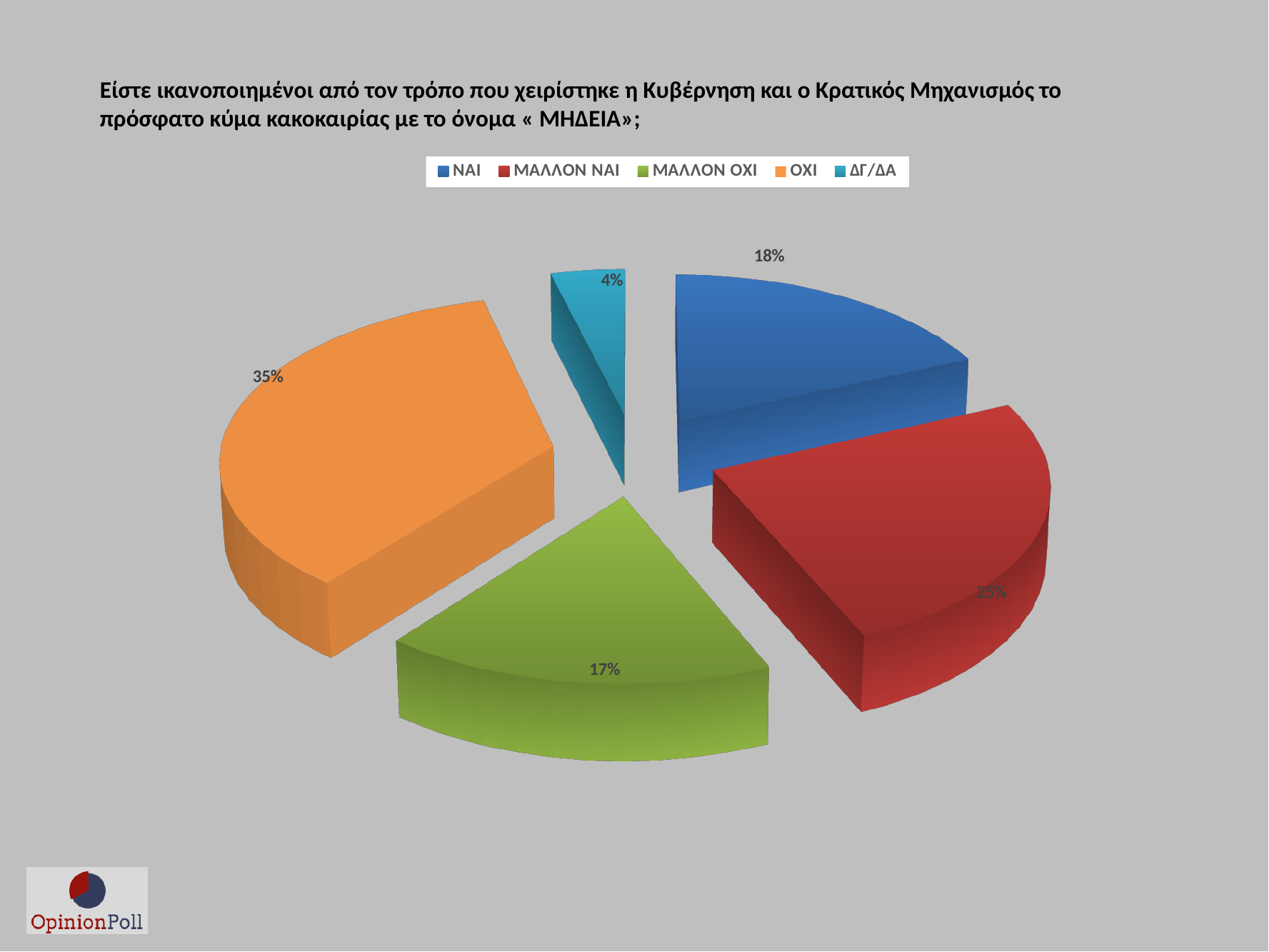
What percentage of respondents answered ΟΧΙ? 35% What colour is the slice for ΟΧΙ? Orange What is the difference in percentage points between ΟΧΙ and ΝΑΙ? 17 What kind of chart is shown on the slide? Pie chart What percentage of respondents answered ΔΓ/ΔΑ? 4% Which response has the largest share of the pie? ΟΧΙ How many slices does the pie chart have? 5 Which response has the smallest share of the pie? ΔΓ/ΔΑ How many entries does the legend list? 5 Which is larger, the share for ΜΑΛΛΟΝ ΝΑΙ or the share for ΜΑΛΛΟΝ ΟΧΙ? ΜΑΛΛΟΝ ΝΑΙ What percentage of respondents answered ΜΑΛΛΟΝ ΝΑΙ? 25% What percentage of respondents answered ΝΑΙ? 18%